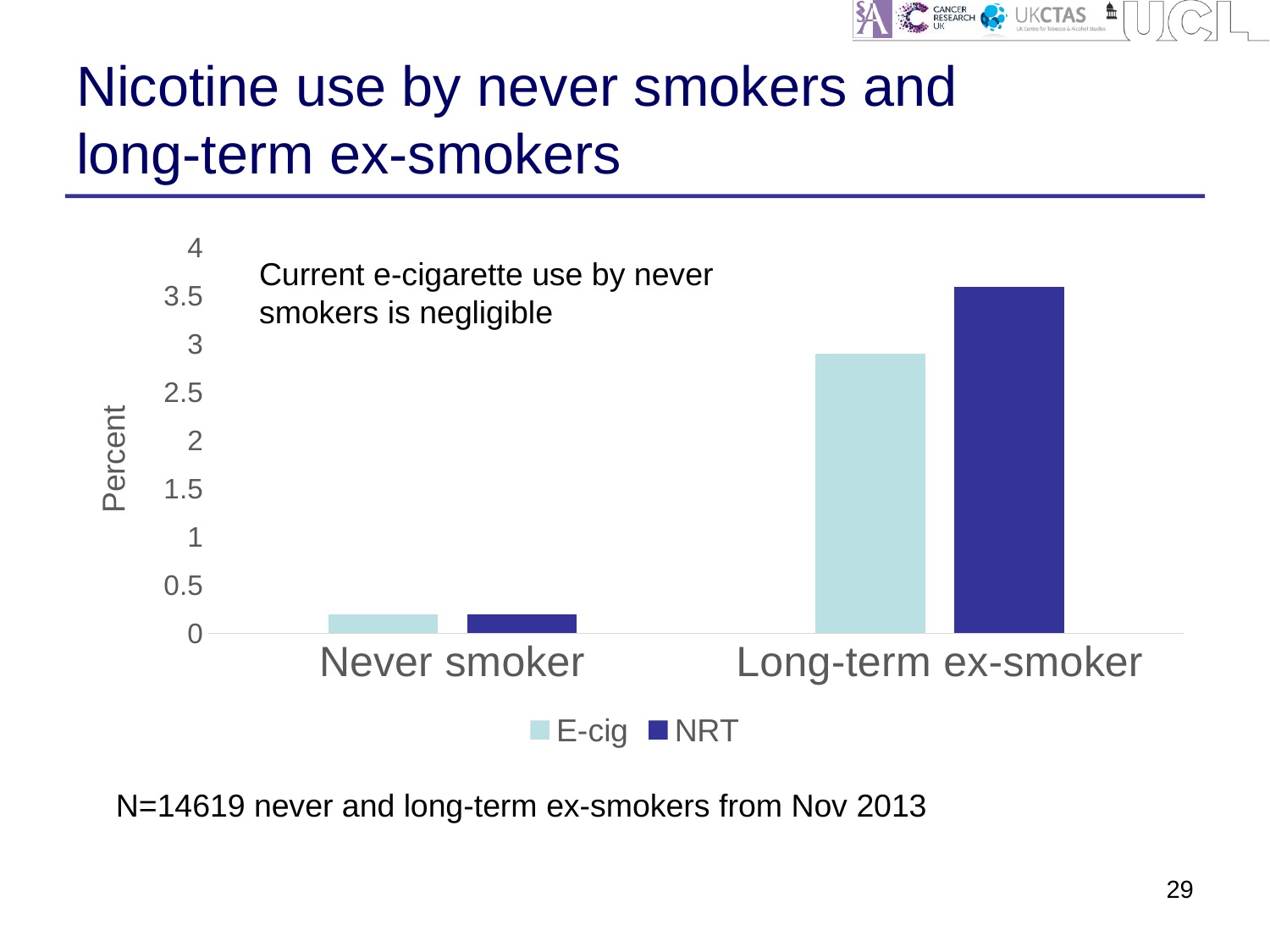
How many categories are shown on the x axis of the chart? 2 Which bar in the chart is the tallest? NRT for Long-term ex-smoker Is the NRT value for Never smoker greater or less than 1? less Is the NRT value for Long-term ex-smoker greater or less than 3? greater Which series are listed in the chart's legend? E-cig and NRT For Long-term ex-smoker, which is larger: the E-cig value or the NRT value? NRT How many series does the chart's legend list? 2 Which category has the higher E-cig value, Never smoker or Long-term ex-smoker? Long-term ex-smoker Is the E-cig value for Never smoker greater or less than 0.5? less What kind of chart is shown on the slide? Bar chart What is the label on the vertical axis of the chart? Percent